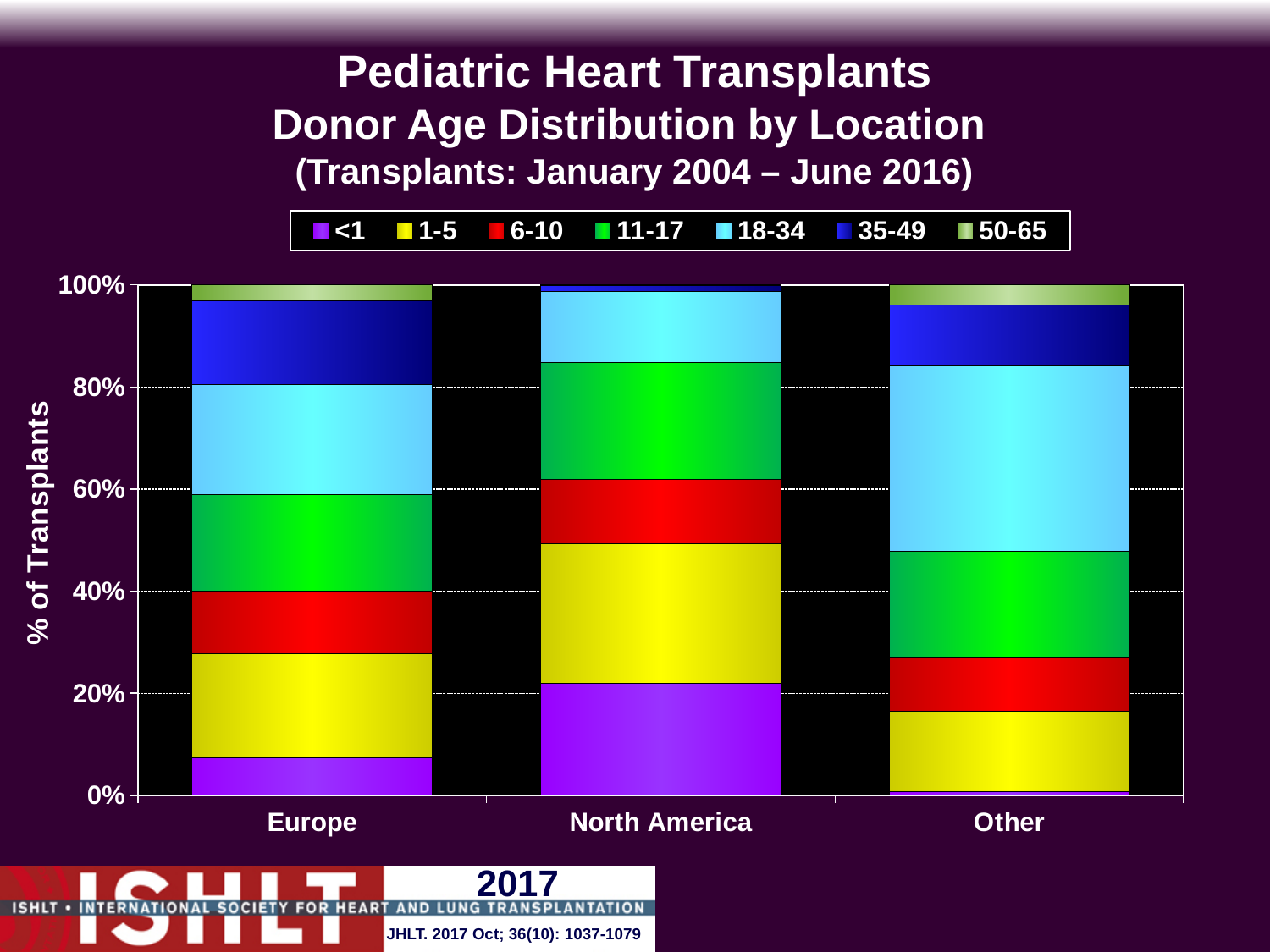
Which location has the smallest share of donors aged <1? Other Which location has the largest share of donors aged 18-34? Other Is the share of donors aged <1 for Europe greater or less than 20%? less Is the share of donors aged 35-49 larger for Europe or for North America? Europe Is the share of donors aged <1 for North America greater or less than 20%? greater Which location has the largest share of donors aged <1? North America What is the label on the y axis of the chart? % of Transplants Which location has the largest share of donors aged 11-17? North America What transplant period is given in the chart title? January 2004 – June 2016 How many locations are shown on the x axis of the chart? 3 How many donor age groups does the legend list? 7 What kind of chart is shown on the slide? Stacked bar chart